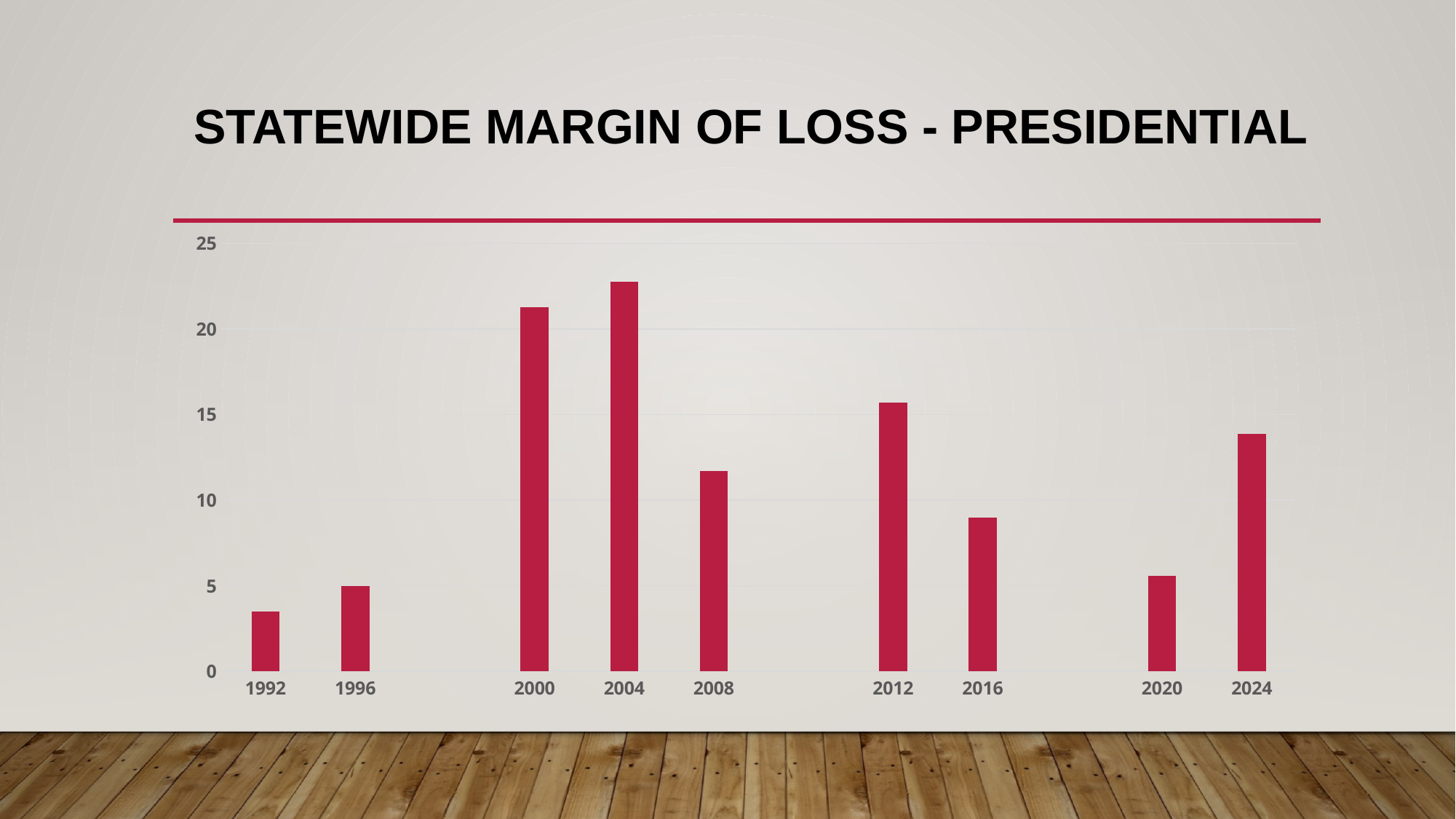
Which is larger, the value for 2024 or the value for 2020? 2024 Do the values rise or fall from 2012 to 2020? fall Which year has the highest statewide margin of loss? 2004 Is the value for 2008 greater or less than 10? greater What is the title of the chart? Statewide Margin of Loss - Presidential What kind of chart is shown on the slide? Bar chart Is the value for 2000 greater or less than 20? greater Is the value for 2016 greater or less than 10? less Which is larger, the value for 2000 or the value for 2008? 2000 How many years (bars) are plotted in the chart? 9 Which year has the lowest statewide margin of loss? 1992